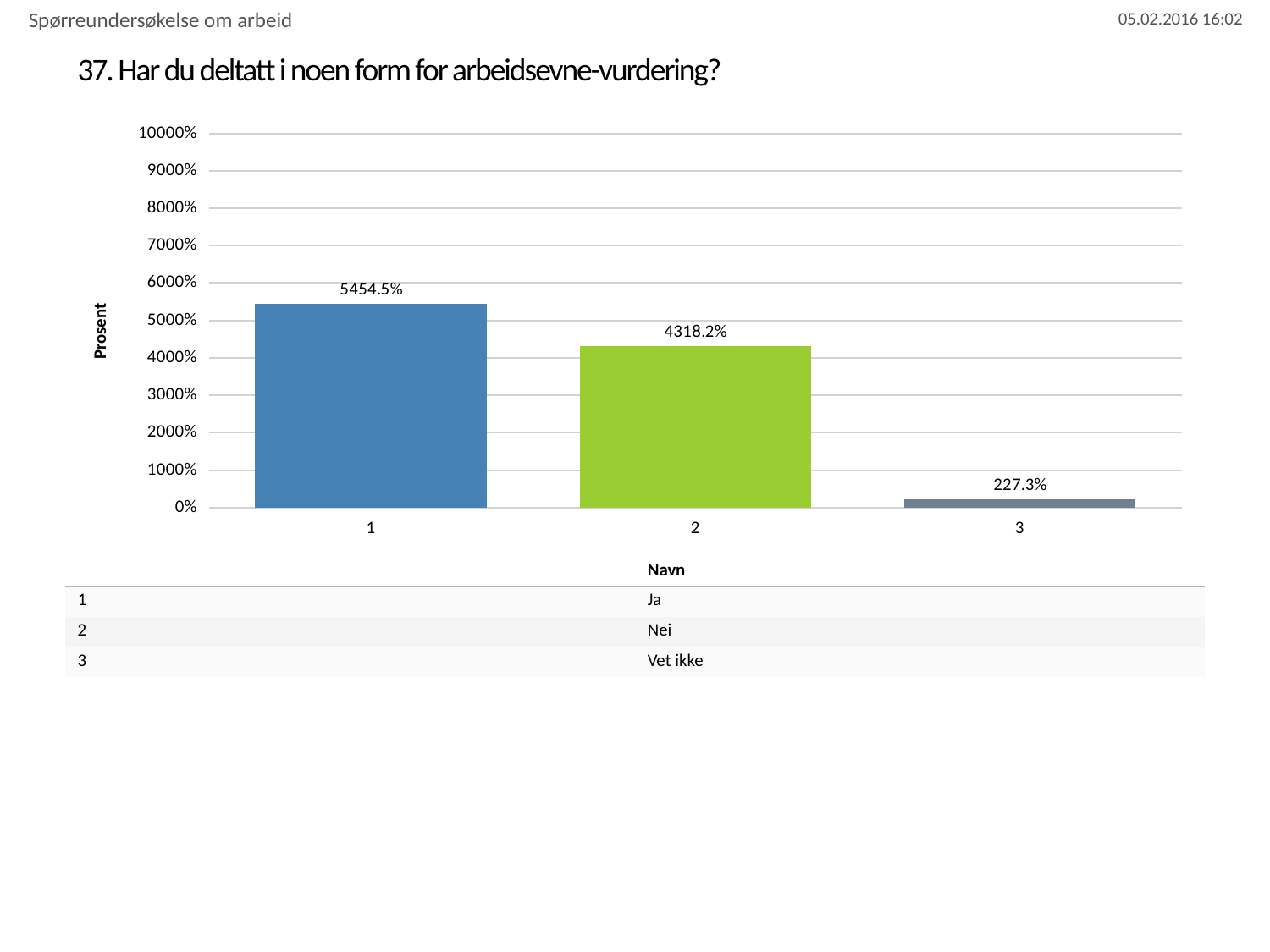
Is the value for category 2 greater or less than 5000%? less Do the values rise or fall from category 1 to category 3? Fall What is the value for category 1 (Ja)? 5454.5% Which category has the lowest value? 3 (Vet ikke) What is the difference between the values for category 1 and category 2? 1136.3% What is the value for category 3 (Vet ikke)? 227.3% Which is larger, the value for category 2 or category 3? Category 2 What is the label of the y axis? Prosent Which category has the highest value? 1 (Ja) What kind of chart is shown on the slide? Bar chart What is the value for category 2 (Nei)? 4318.2% How many categories are shown in the chart? 3